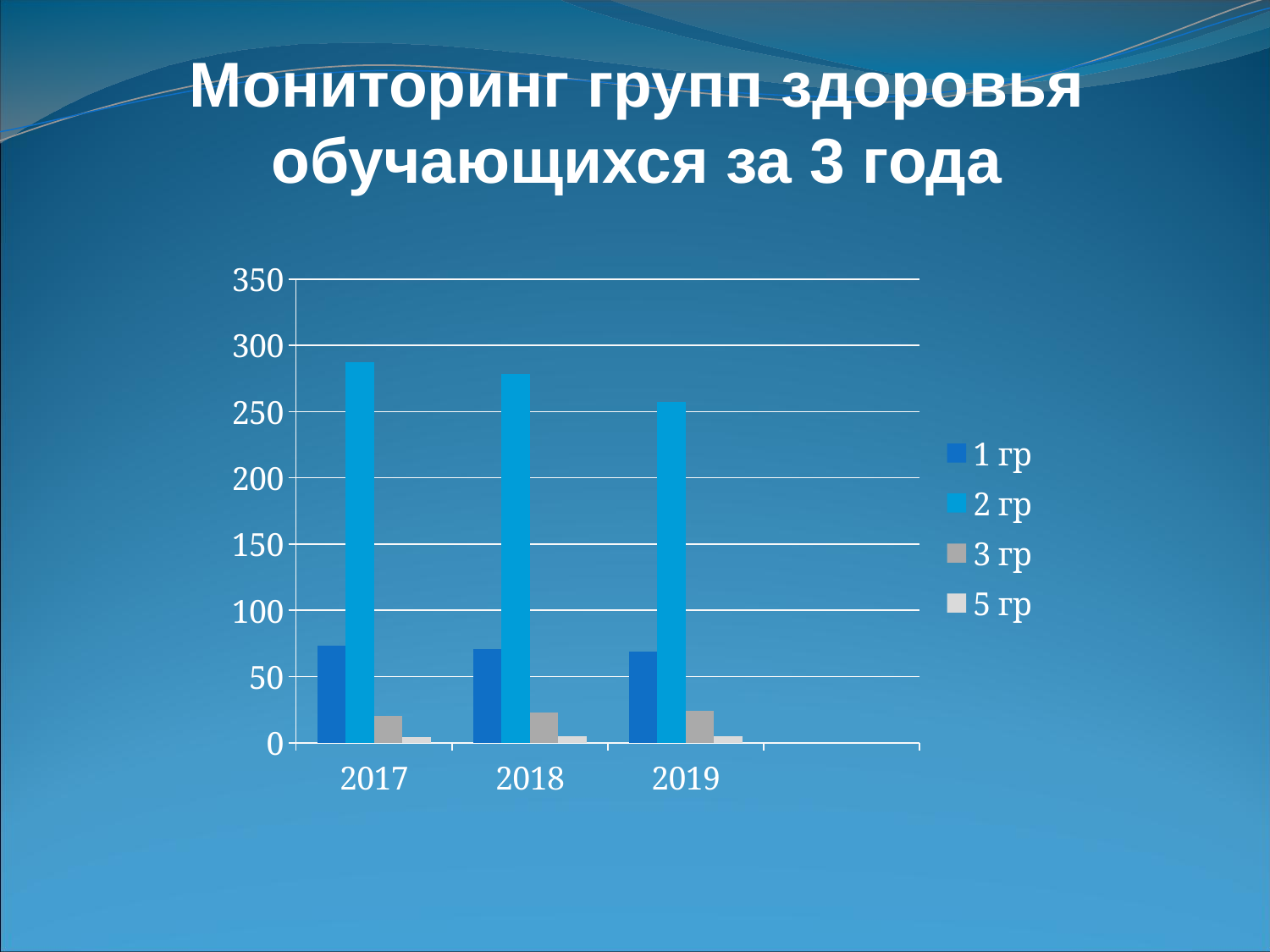
How many years are shown on the x axis of the chart? 3 Which series has the highest value in 2017? 2 гр Which series has the lowest value in 2018? 5 гр Is the value for 1 гр in 2018 greater or less than 100? less How many series does the chart legend list? 4 Which is larger: the value for 2 гр in 2017 or in 2019? 2017 Is the value for 3 гр in 2019 greater or less than 50? less Is the value for 2 гр in 2017 greater or less than 250? greater Do the values for 2 гр rise or fall from 2017 to 2019? fall What kind of chart is shown on the slide? bar chart What is the title of the slide containing the chart? Мониторинг групп здоровья обучающихся за 3 года In which year is the value for 2 гр the highest? 2017